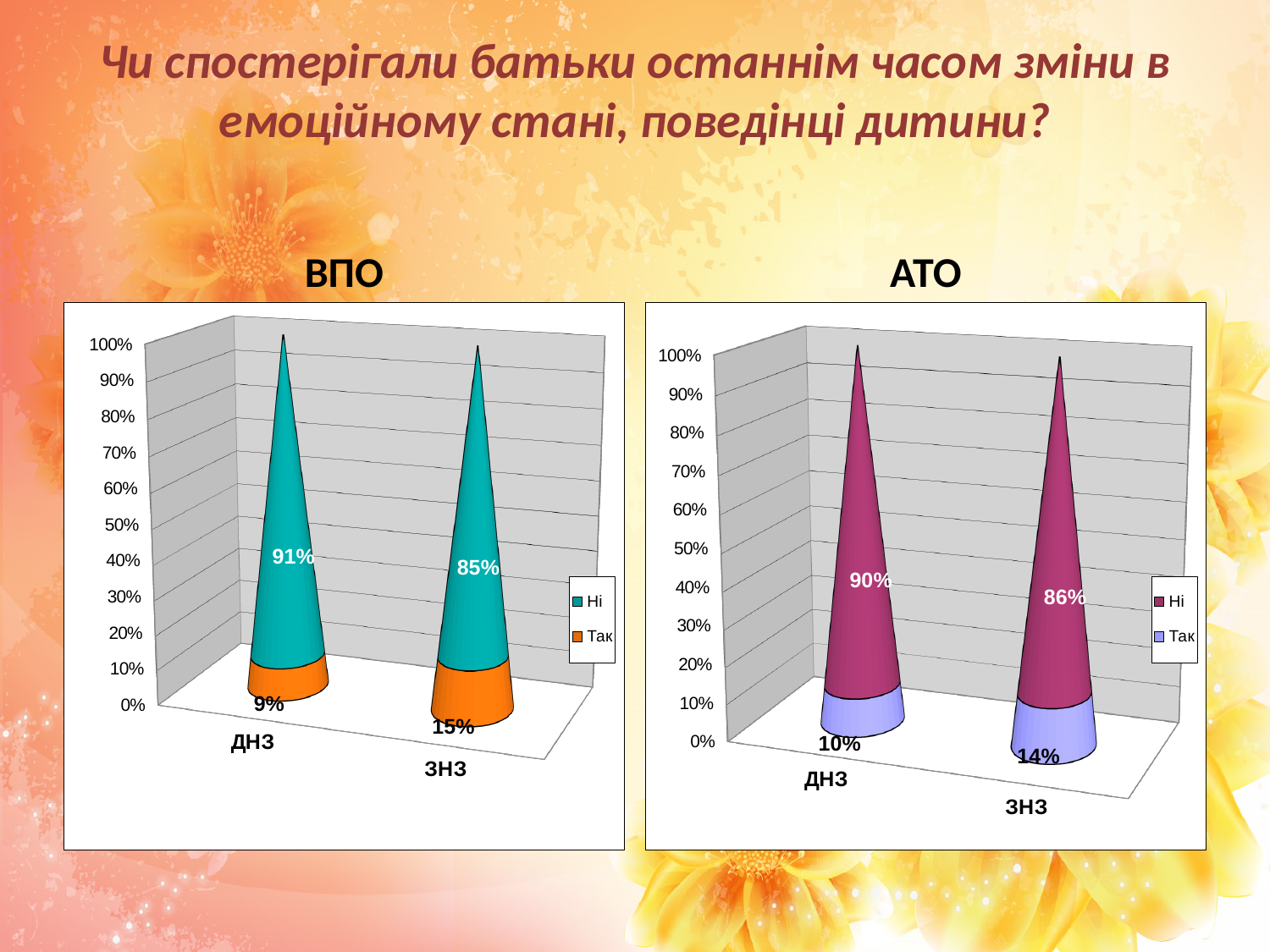
In the ВПО chart, what is the value of Ні for ДНЗ? 91% In the ВПО chart, what is the value of Так for ЗНЗ? 15% In the ВПО chart, which category has the higher value for Так? ЗНЗ In the ВПО chart, what is the difference between the Ні values for ДНЗ and ЗНЗ? 6% In the АТО chart, what is the value of Ні for ЗНЗ? 86% In the АТО chart, what is the value of Так for ДНЗ? 10% In the АТО chart, which category has the lower value for Ні? ЗНЗ How many series does the legend of the АТО chart list? 2 How many categories are shown on the x axis of the ВПО chart? 2 In the АТО chart, is the Ні value for ДНЗ larger or smaller than the Ні value for ЗНЗ? larger What type of chart is the ВПО chart? stacked bar chart In the АТО chart, what is the difference between the Так values for ЗНЗ and ДНЗ? 4%